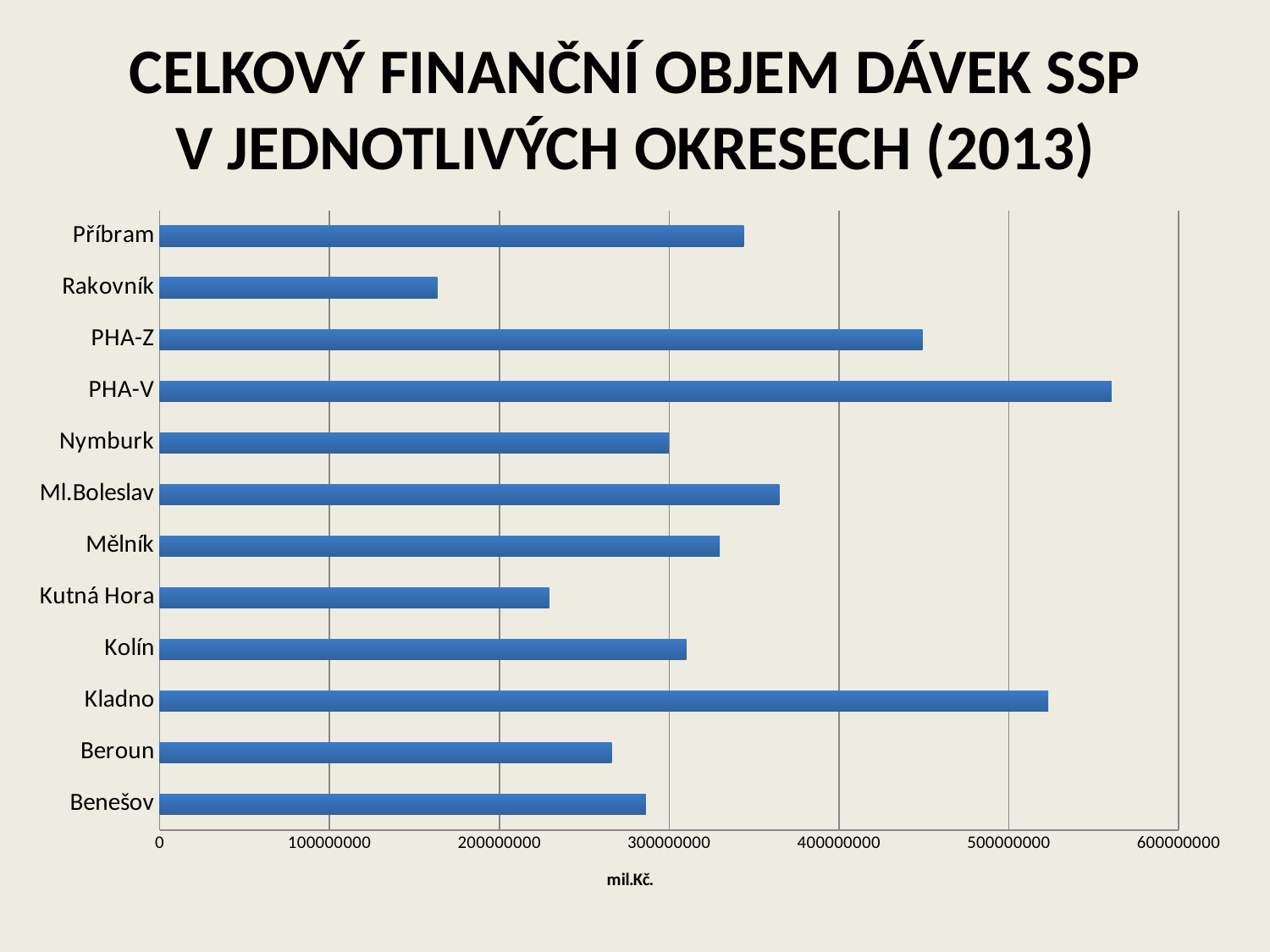
Which has the larger value, Kutná Hora or Beroun? Beroun Which district has the lowest value on the chart? Rakovník Which district has the highest value on the chart? PHA-V How many districts (categories) are shown on the chart? 12 Is the value for Rakovník greater or less than 200000000? less Is the value for PHA-Z greater or less than 400000000? greater What kind of chart is shown on the slide? bar chart Which has the larger value, Kladno or PHA-Z? Kladno Is the value for Kladno greater or less than 500000000? greater What is the label shown on the horizontal axis of the chart? mil.Kč.